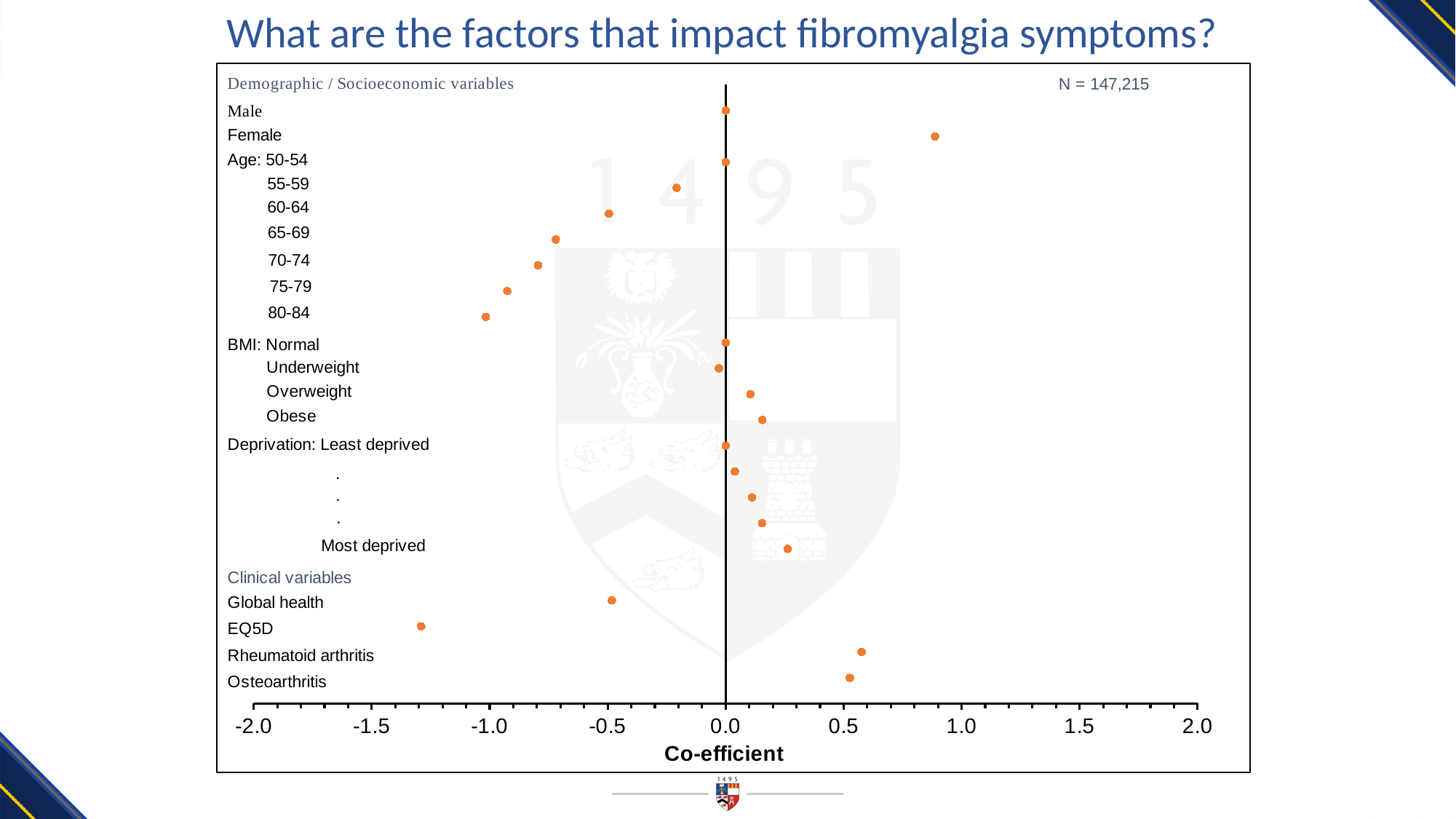
What is the title of the x axis? Co-efficient Which category has the lowest co-efficient? EQ5D Is the co-efficient for Global health greater or less than 0.0? less How do the co-efficients change across the age groups from 50-54 to 80-84? They fall What sample size (N) is shown on the chart? N = 147,215 Is the co-efficient for EQ5D greater or less than -1.0? less What type of chart is shown on the slide? Dot plot (scatter plot) Which category has the highest co-efficient? Female Is the co-efficient for Age 80-84 greater or less than -0.5? less Which has the larger co-efficient, Female or Rheumatoid arthritis? Female How many clinical variables are plotted on the chart? 4